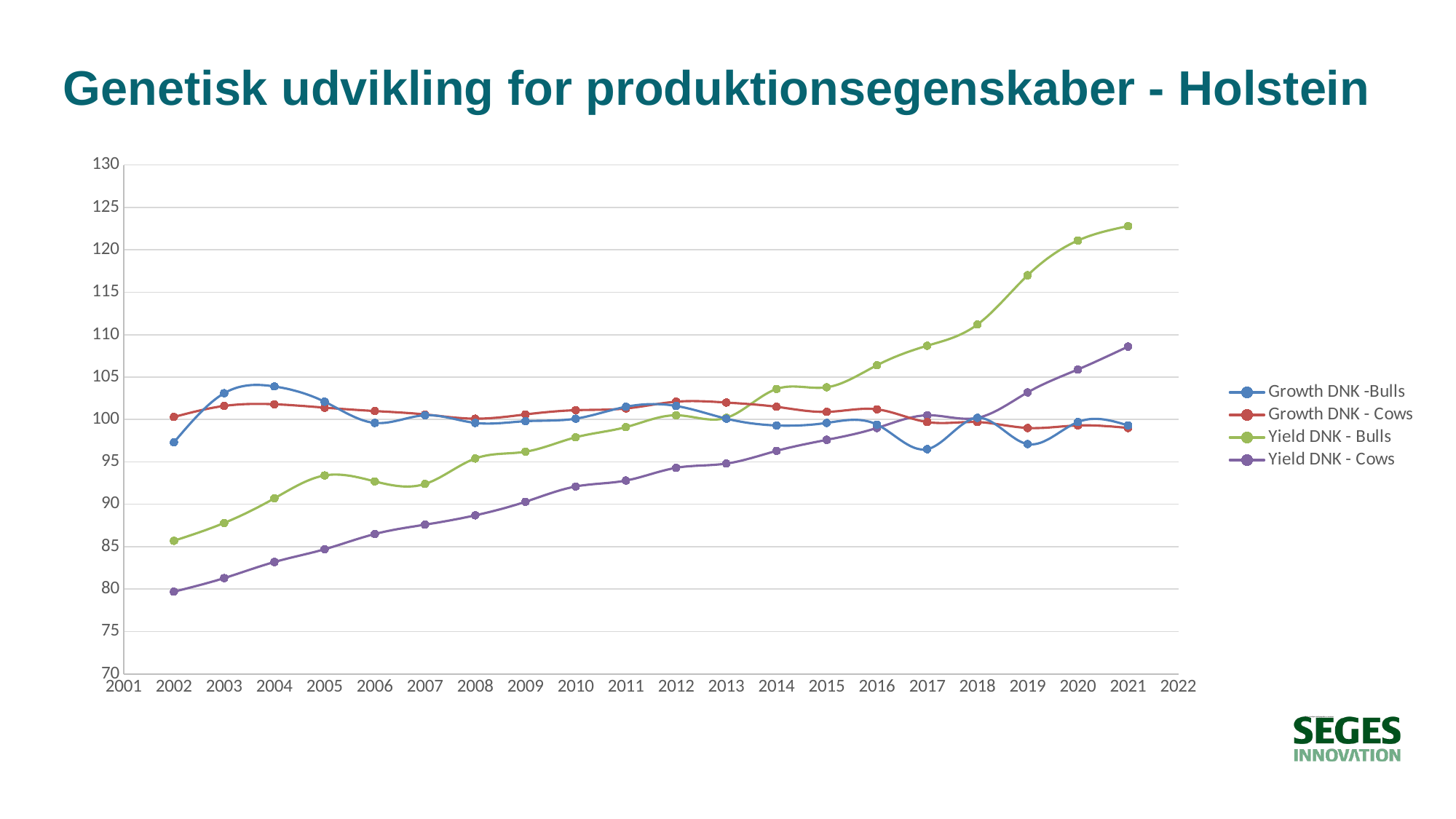
Does the Yield DNK - Cows series rise or fall from 2002 to 2021? rise How many years have data points plotted for each series? 20 Does the Yield DNK - Bulls series rise or fall from 2002 to 2021? rise What is the title of the slide? Genetisk udvikling for produktionsegenskaber - Holstein Is the value for Growth DNK -Bulls in 2017 greater or less than 100? less Which series has the highest value in 2021? Yield DNK - Bulls What kind of chart is shown on the slide? line chart Is the value for Yield DNK - Bulls in 2021 greater or less than 120? greater Is the value for Yield DNK - Cows in 2002 greater or less than 85? less How many series does the legend list? 4 Which series has the lowest value in 2002? Yield DNK - Cows In 2002, which is higher: Yield DNK - Bulls or Yield DNK - Cows? Yield DNK - Bulls